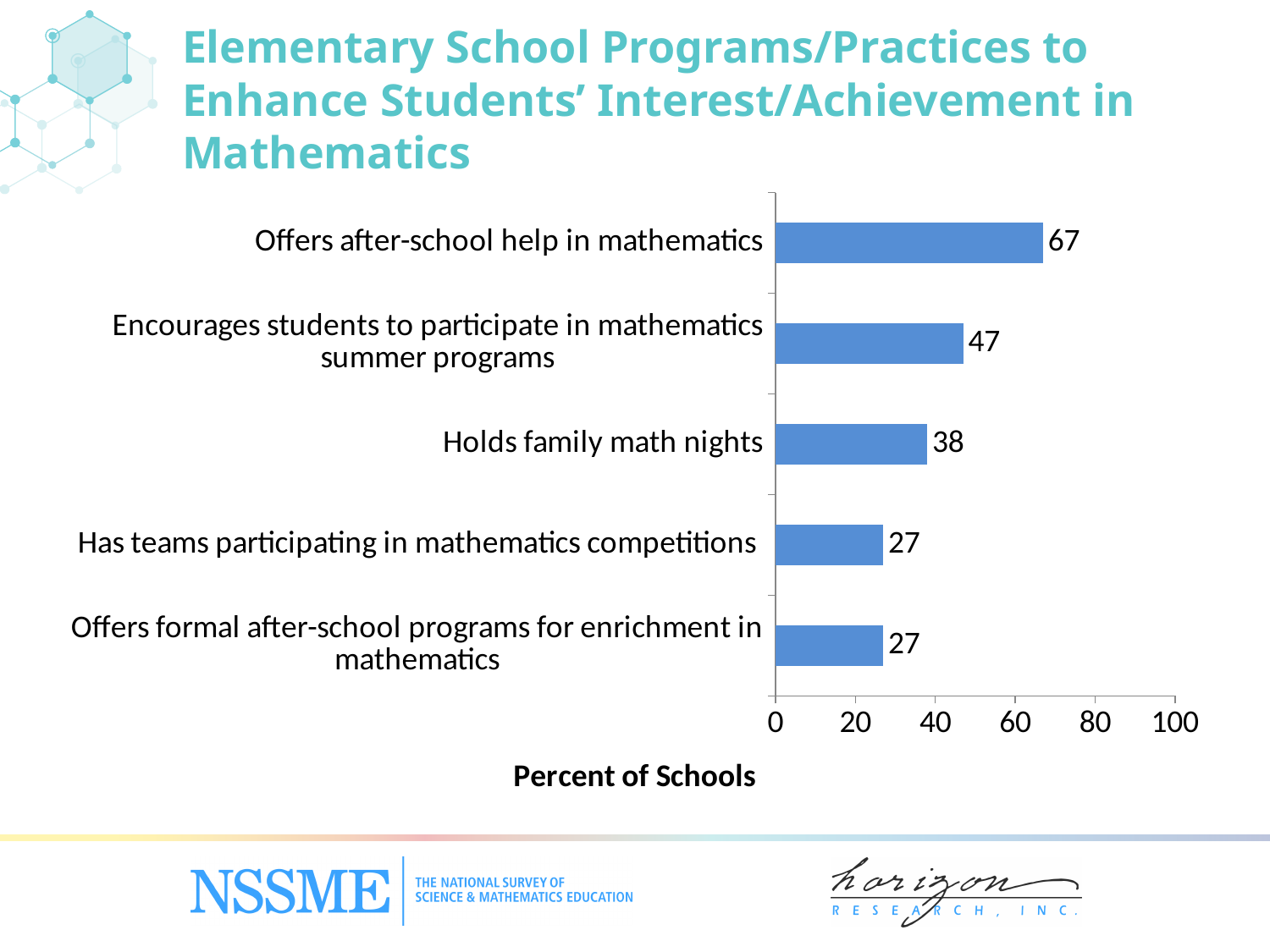
What kind of chart is shown on the slide? Bar chart How many programs/practices are shown in the chart? 5 Is the value for offering formal after-school programs for enrichment in mathematics greater or less than 40? less What is the label of the horizontal axis? Percent of Schools What percent of schools have teams participating in mathematics competitions? 27 What percent of schools encourage students to participate in mathematics summer programs? 47 What is the difference in percent of schools between offering after-school help in mathematics and holding family math nights? 29 What percent of schools offer after-school help in mathematics? 67 Which program/practice has the highest percent of schools? Offers after-school help in mathematics What percent of schools hold family math nights? 38 Which is larger: the percent of schools that hold family math nights or the percent that encourage students to participate in mathematics summer programs? Encourages students to participate in mathematics summer programs What is the difference in percent of schools between encouraging participation in mathematics summer programs and having teams in mathematics competitions? 20